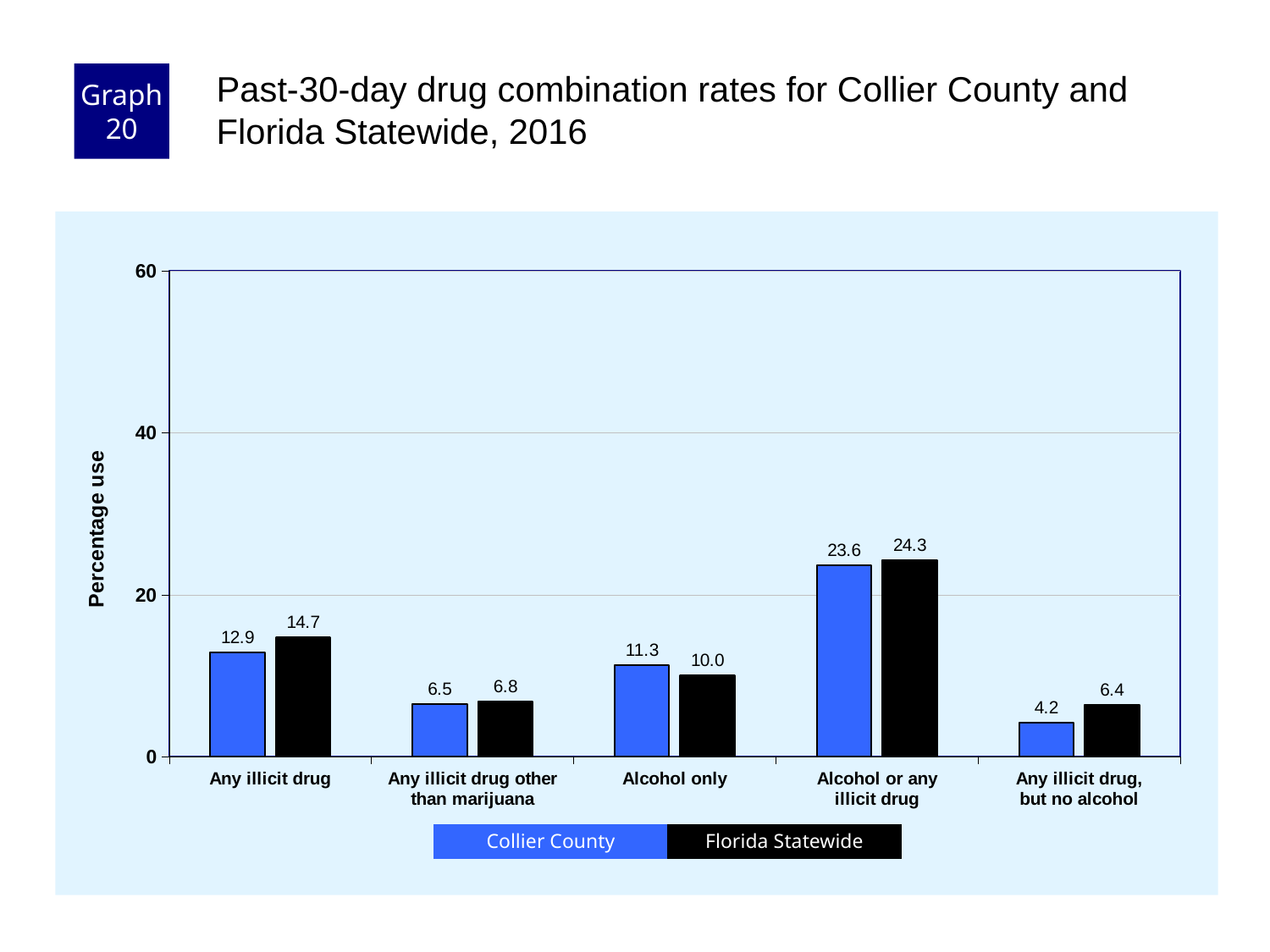
What is the difference between the Florida Statewide and Collier County values for Any illicit drug, but no alcohol? 2.2 What is the Florida Statewide value for Any illicit drug, but no alcohol? 6.4 How many categories are shown on the x axis? 5 What kind of chart is shown on the slide? bar chart What is the label of the y axis? Percentage use Is the Florida Statewide value for Alcohol or any illicit drug greater or less than 20? greater For Alcohol only, which is larger: Collier County or Florida Statewide? Collier County What is the Florida Statewide value for Alcohol only? 10.0 Which category has the highest Collier County value? Alcohol or any illicit drug How many series does the legend list? 2 Which category has the lowest Florida Statewide value? Any illicit drug, but no alcohol What is the Collier County value for Any illicit drug? 12.9